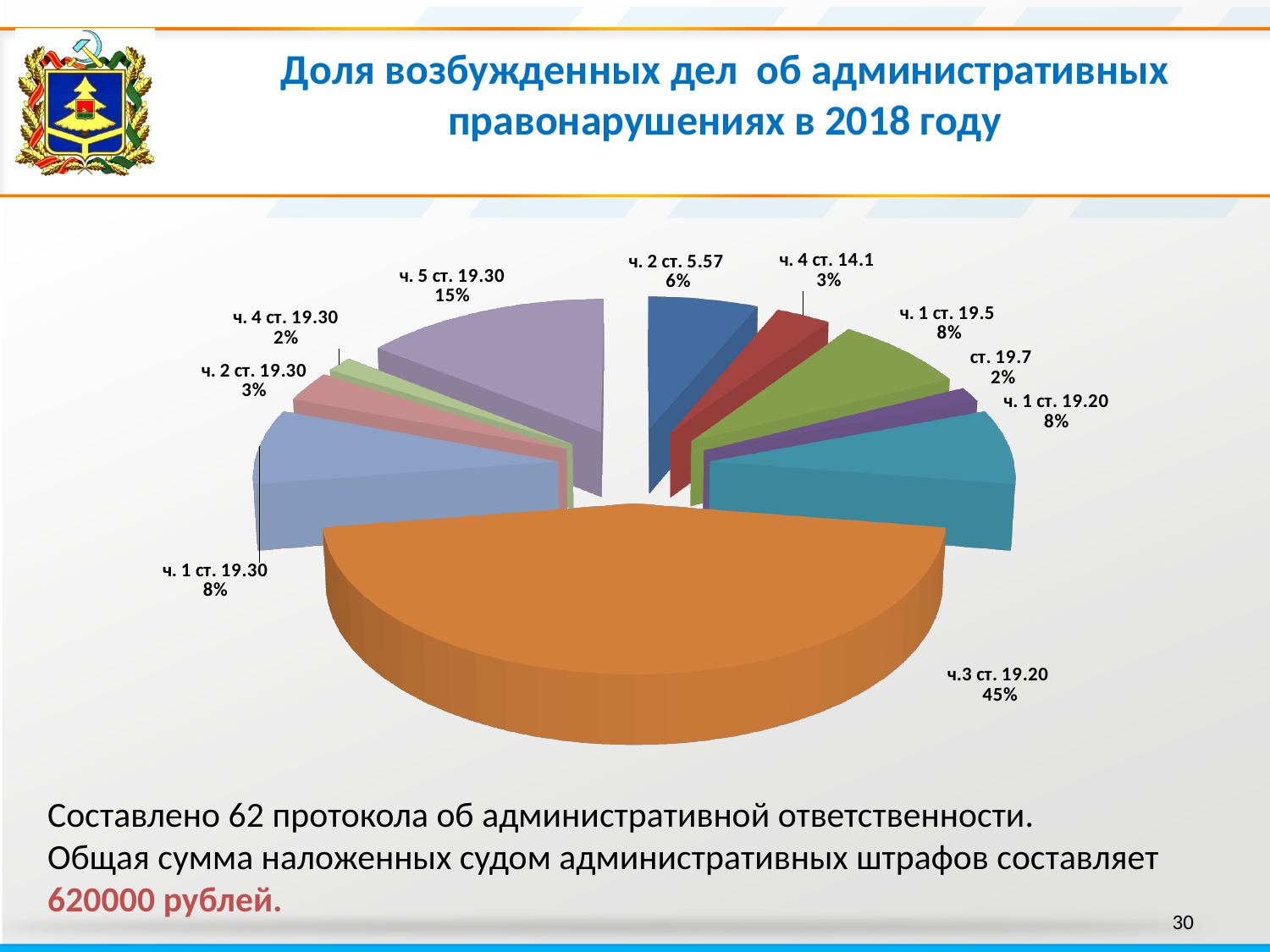
Which is larger, the share of ч. 1 ст. 19.5 or the share of ч. 2 ст. 19.30? ч. 1 ст. 19.5 What is the title of the chart on the slide? Доля возбужденных дел об административных правонарушениях в 2018 году What kind of chart is shown on the slide? Pie chart What is the value shown for ч. 4 ст. 14.1? 3% What is the difference between the shares of ч.3 ст. 19.20 and ч. 5 ст. 19.30? 30% How many slices does the pie chart have? 10 What share of the pie does ч.3 ст. 19.20 have? 45% What is the value shown for ст. 19.7? 2% What is the value shown for ч. 2 ст. 5.57? 6% What share of the pie does ч. 5 ст. 19.30 have? 15% What is the difference between the shares of ч. 2 ст. 5.57 and ч. 4 ст. 14.1? 3% Which category has the largest slice of the pie? ч.3 ст. 19.20